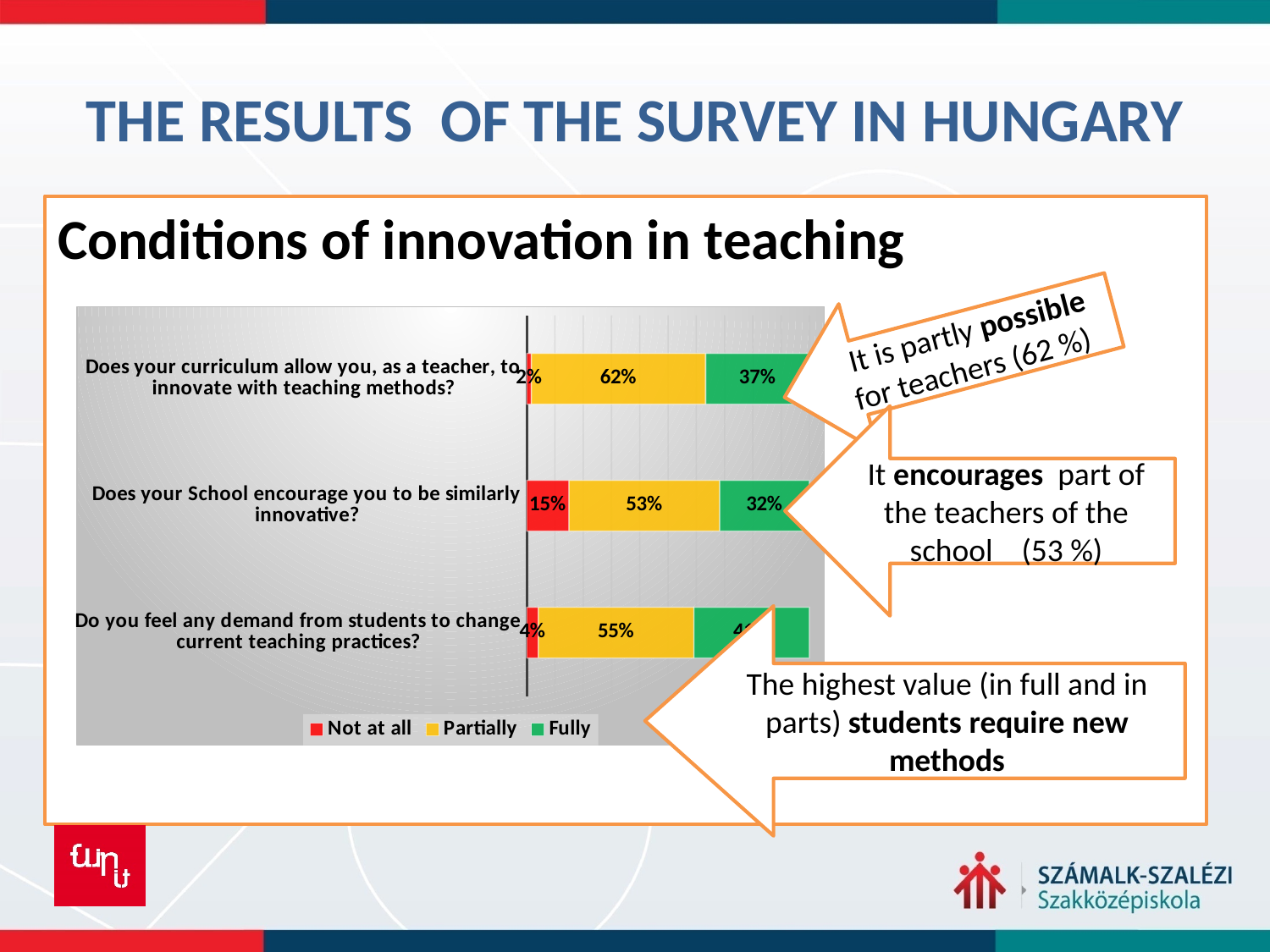
Which question has the highest 'Partially' value? Does your curriculum allow you, as a teacher, to innovate with teaching methods? What is the difference between the 'Partially' values for the curriculum question (62%) and the school encouragement question (53%)? 9 percentage points What is the 'Fully' value for 'Does your School encourage you to be similarly innovative?' 32% How many questions (categories) are plotted in the chart? 3 How many series does the legend list? 3 What is the 'Partially' value for 'Does your curriculum allow you, as a teacher, to innovate with teaching methods?' 62% What is the 'Not at all' value for 'Does your School encourage you to be similarly innovative?' 15% Which is larger: the 'Fully' value for the curriculum question or the 'Fully' value for the school encouragement question? the curriculum question (37%) What is the 'Partially' value for 'Do you feel any demand from students to change current teaching practices?' 55% Which colour represents the 'Fully' series in the chart? green What kind of chart is shown on the slide? stacked bar chart Which question has the lowest 'Not at all' value? Does your curriculum allow you, as a teacher, to innovate with teaching methods?